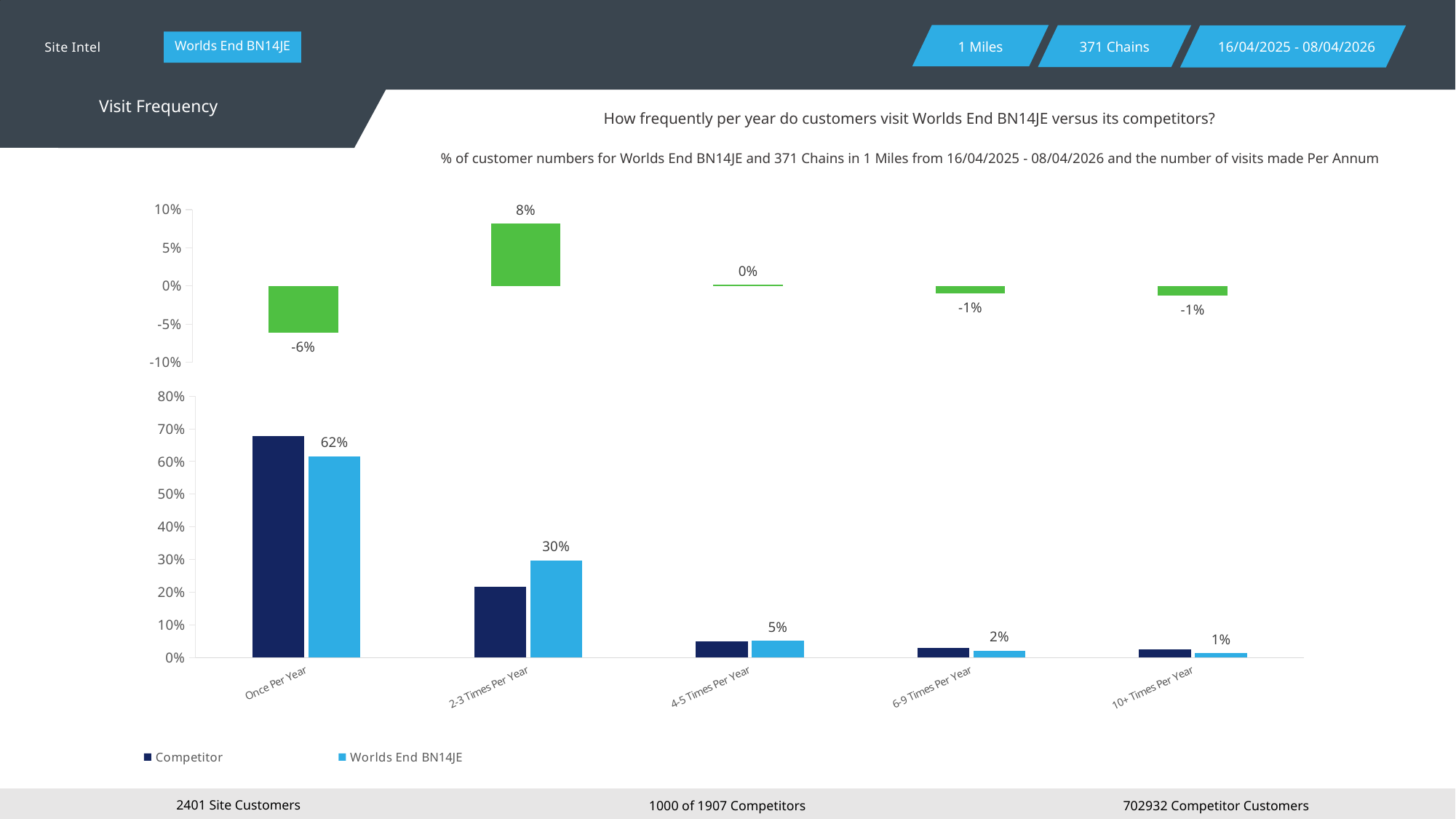
In the bottom bar chart, which category has the highest value for Worlds End BN14JE? Once Per Year In the bottom bar chart, which category has the lowest value for Worlds End BN14JE? 10+ Times Per Year In the top chart, what is the value shown for 2-3 Times Per Year? 8% In the bottom bar chart, what is the value for Worlds End BN14JE for Once Per Year? 62% In the top chart, what is the value shown for Once Per Year? -6% How many series does the legend of the bottom bar chart list? 2 In the bottom bar chart, what is the value for Worlds End BN14JE for 4-5 Times Per Year? 5% In the bottom bar chart, is the Competitor value for 2-3 Times Per Year greater or less than 30%? less How many categories are shown on the x axis of the bottom bar chart? 5 In the bottom bar chart, for Once Per Year, which is larger: the Competitor bar or the Worlds End BN14JE bar? Competitor In the bottom bar chart, what is the value for Worlds End BN14JE for 2-3 Times Per Year? 30% In the bottom bar chart, what is the difference between the Worlds End BN14JE values for Once Per Year and 2-3 Times Per Year? 32%